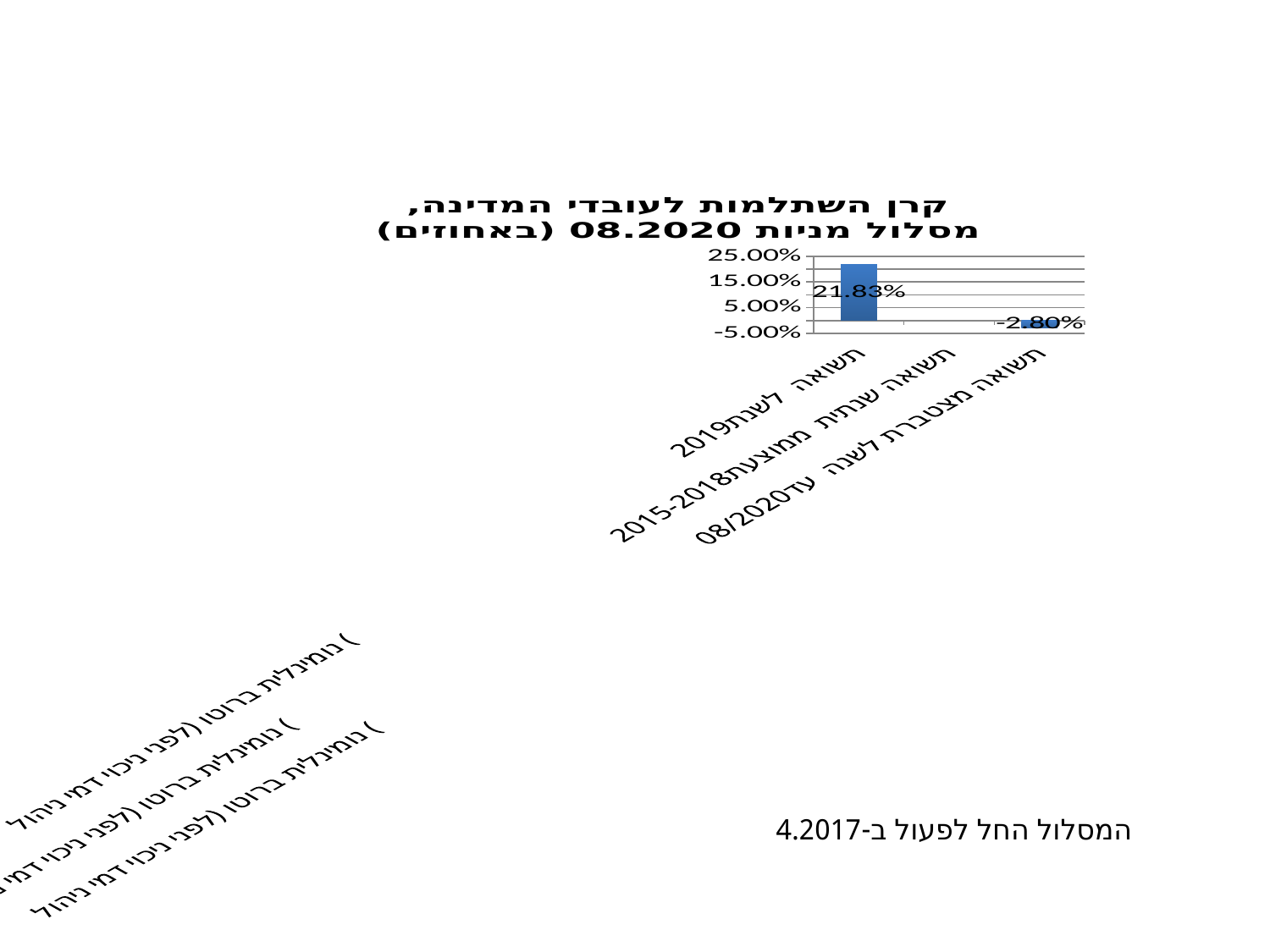
What is the highest tick value shown on the vertical axis of the chart? 25.00% What is the value shown for תשואה לשנת 2019? 21.83% Is the value for תשואה לשנת 2019 greater or less than 15.00%? greater Is the value for תשואה מצטברת לשנה עד 08/2020 greater or less than 5.00%? less Which category has the highest value in the chart? תשואה לשנת 2019 What is the value shown for תשואה מצטברת לשנה עד 08/2020? -2.80% Which is larger: the value for תשואה לשנת 2019 or the value for תשואה מצטברת לשנה עד 08/2020? תשואה לשנת 2019 Do the values fall or rise from the first category to the last category along the x axis? fall Which labelled value in the chart is the lowest? תשואה מצטברת לשנה עד 08/2020 How many categories are shown on the x axis of the chart? 3 What is the difference between the value for תשואה לשנת 2019 and the value for תשואה מצטברת לשנה עד 08/2020? 24.63 percentage points What type of chart is shown on the slide? bar chart